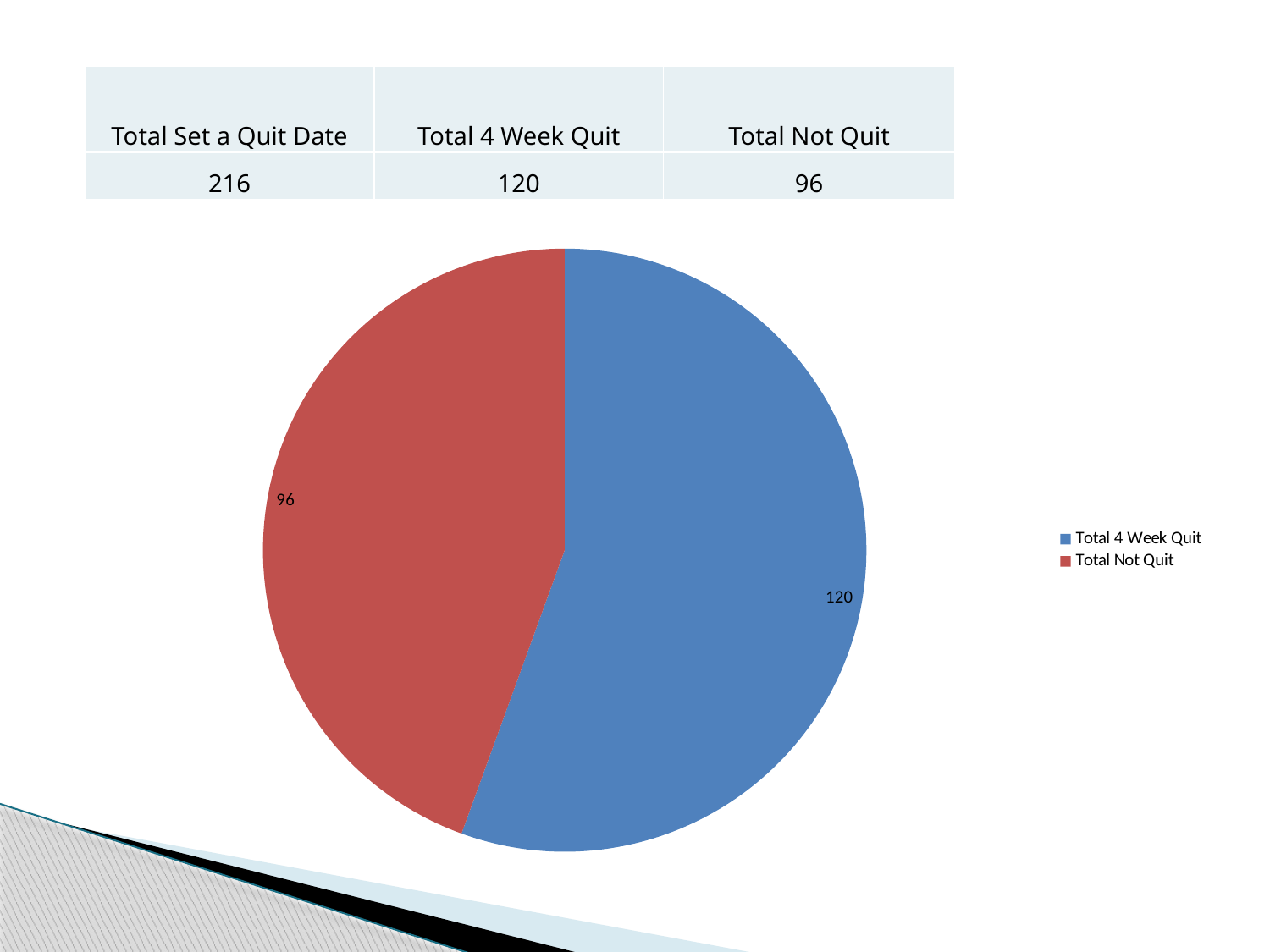
Which slice of the pie chart is the largest? Total 4 Week Quit What is the value for Total 4 Week Quit in the pie chart? 120 What colour is the Total 4 Week Quit slice in the pie chart? blue Which slice of the pie chart is the smallest? Total Not Quit How many entries does the legend of the pie chart list? 2 What is the difference between the Total 4 Week Quit and Total Not Quit values in the pie chart? 24 How many slices does the pie chart have? 2 What kind of chart is shown on the slide? pie chart What is the value for Total Not Quit in the pie chart? 96 What colour is the Total Not Quit slice in the pie chart? red Which is larger in the pie chart, Total 4 Week Quit or Total Not Quit? Total 4 Week Quit What is the total of the two slices in the pie chart? 216